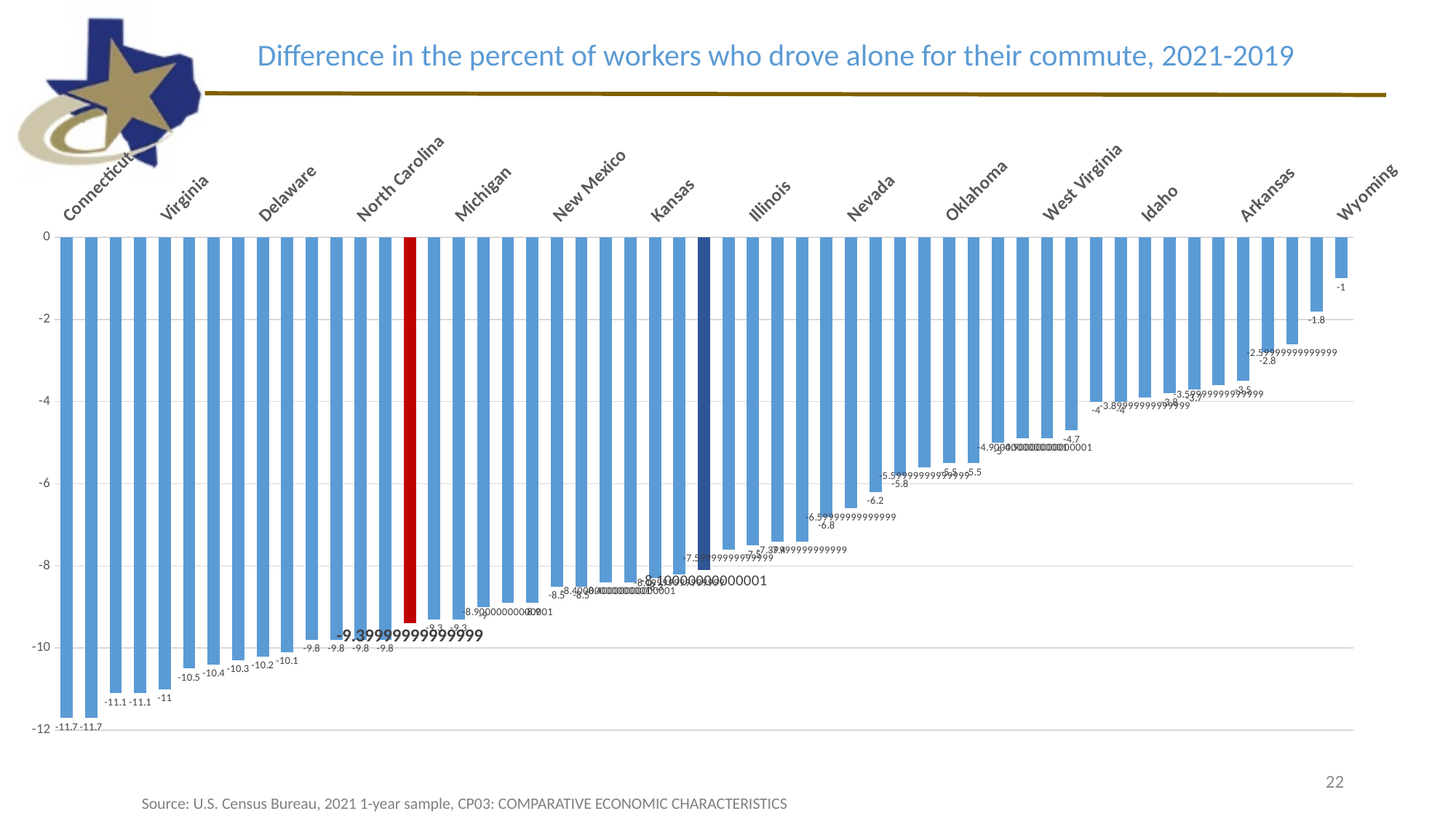
What is the difference between the values for Connecticut and Wyoming? 10.7 Do the values rise or fall moving from left to right along the x axis? rise Is the value for West Virginia greater or less than -4? less Is the value for Nevada greater or less than -8? greater Which is larger, the value for Wyoming or the value for Connecticut? Wyoming What kind of chart is shown on the slide? bar chart Which labeled state has the lowest (most negative) value? Connecticut What is the title of the chart? Difference in the percent of workers who drove alone for their commute, 2021-2019 Is the value for Kansas greater or less than -8? less Which labeled state has the highest value? Wyoming What is the value for Connecticut? -11.7 What is the value for Wyoming? -1